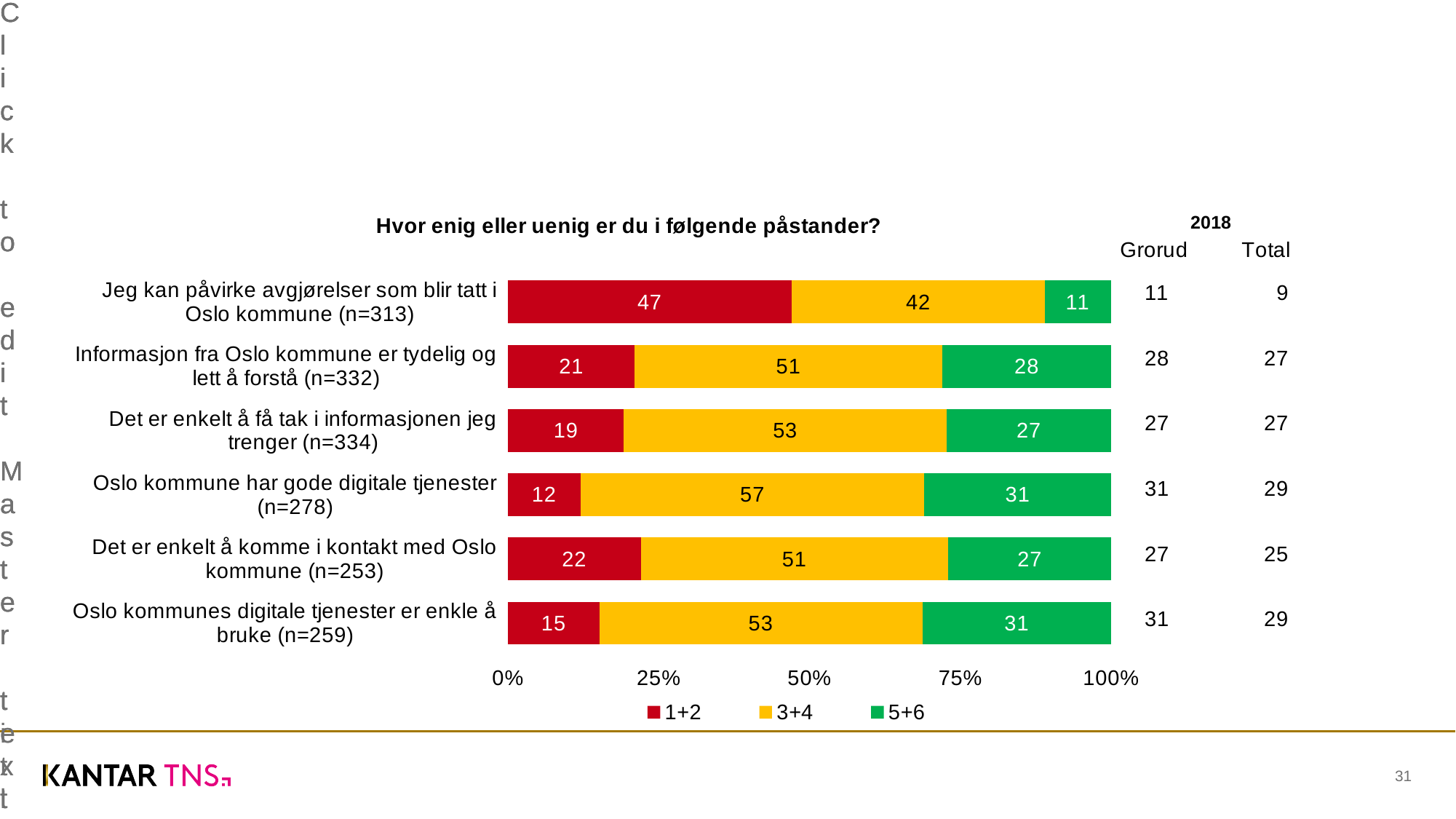
What is the title of the chart? Hvor enig eller uenig er du i følgende påstander? Which statement has the lowest value for the 5+6 series? Jeg kan påvirke avgjørelser som blir tatt i Oslo kommune (n=313) What is the total of the stacked bar for 'Oslo kommune har gode digitale tjenester (n=278)'? 100 How many statements (categories) are plotted in the chart? 6 How many series does the legend list? 3 What kind of chart is shown on the slide? Stacked bar chart What is the difference between the 3+4 value and the 1+2 value for 'Informasjon fra Oslo kommune er tydelig og lett å forstå (n=332)'? 30 Which statement has the highest value for the 1+2 series? Jeg kan påvirke avgjørelser som blir tatt i Oslo kommune (n=313) What is the value of the 3+4 series for 'Det er enkelt å få tak i informasjonen jeg trenger (n=334)'? 53 What is the value of the 1+2 series for 'Jeg kan påvirke avgjørelser som blir tatt i Oslo kommune (n=313)'? 47 Which is larger: the 1+2 value for 'Det er enkelt å komme i kontakt med Oslo kommune (n=253)' or the 1+2 value for 'Oslo kommunes digitale tjenester er enkle å bruke (n=259)'? Det er enkelt å komme i kontakt med Oslo kommune (n=253) What is the value of the 5+6 series for 'Oslo kommune har gode digitale tjenester (n=278)'? 31